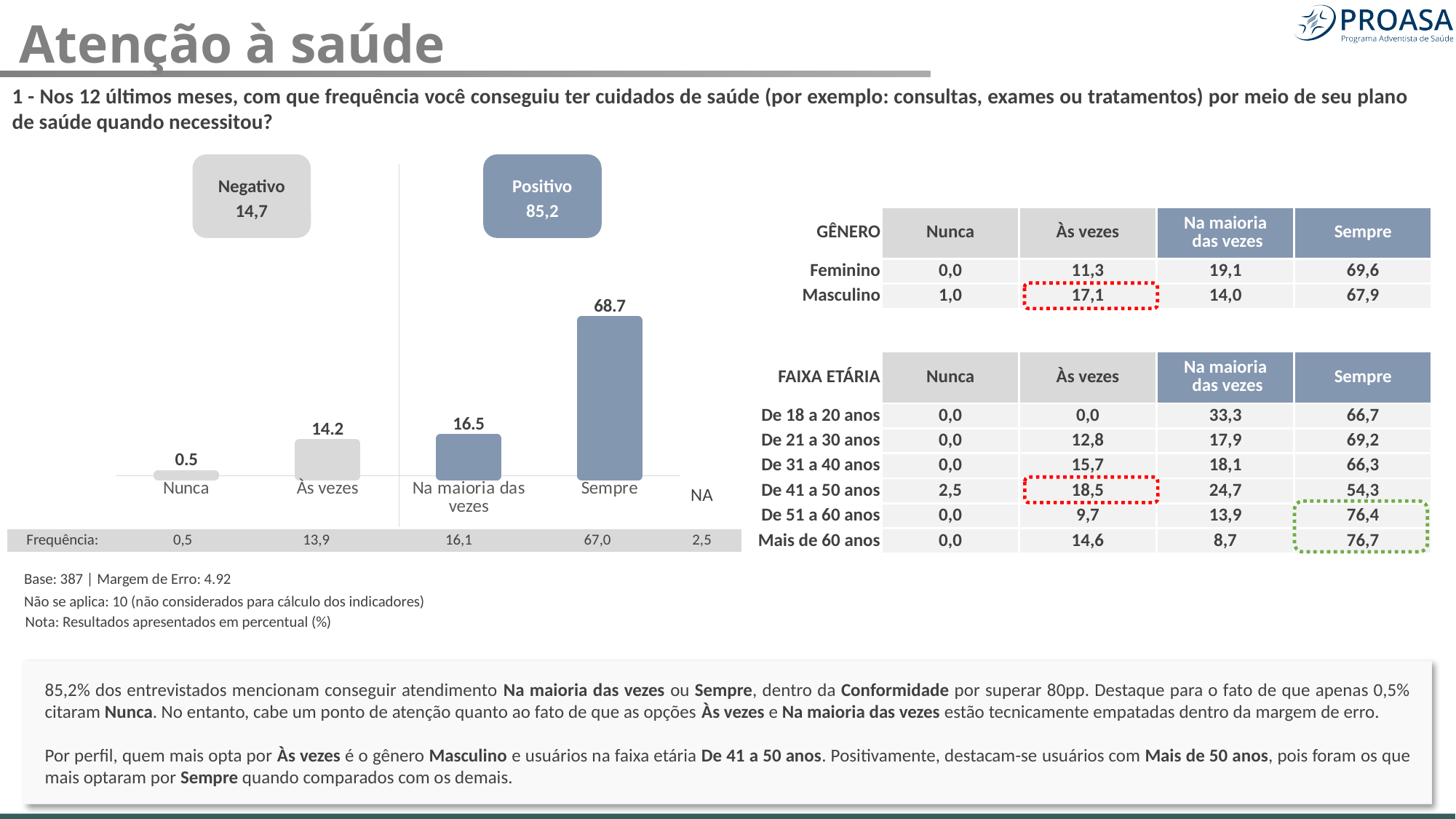
Which category has the highest bar? Sempre What is the value of the bar for Na maioria das vezes? 16.5 What value is shown in the Positivo box above the chart? 85,2 What kind of chart is shown on the slide? Bar chart Which is larger, the bar for Às vezes or the bar for Na maioria das vezes? Na maioria das vezes What is the value of the bar for Sempre? 68.7 What is the difference between the values for Sempre and Na maioria das vezes? 52.2 What is the difference between the values for Na maioria das vezes and Às vezes? 2.3 Which category has the lowest bar? Nunca What is the value of the bar for Às vezes? 14.2 How many bars are plotted in the chart? 4 What is the value of the bar for Nunca? 0.5